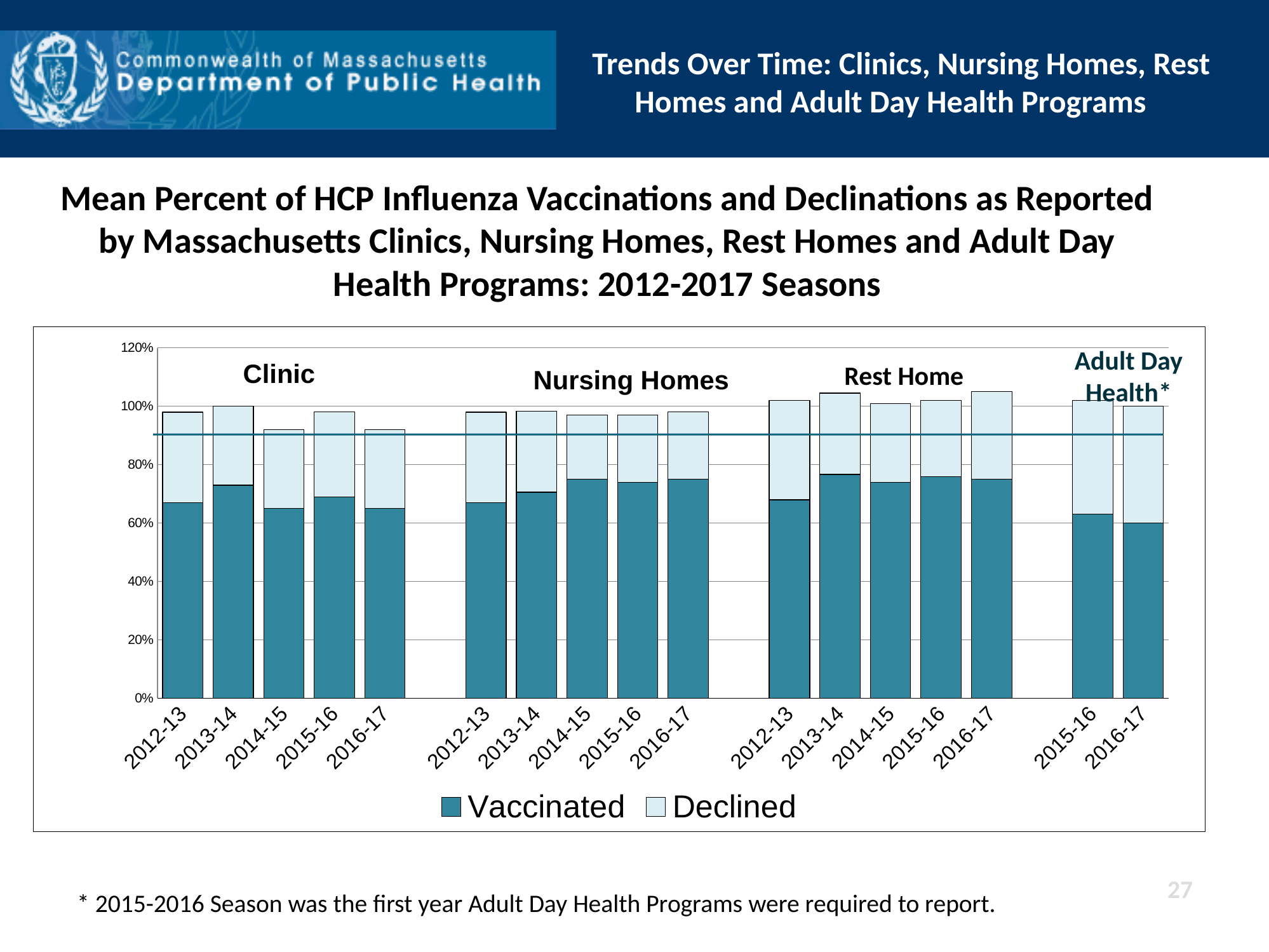
Within the Clinic group, which season has the highest Vaccinated value? 2013-14 Is the Vaccinated value for Clinic 2013-14 greater or less than 80%? less Which is larger, the Vaccinated value for Clinic 2013-14 or for Clinic 2014-15? Clinic 2013-14 Is the Vaccinated value for Adult Day Health 2015-16 greater or less than 60%? greater What kind of chart is shown on the slide? Stacked bar chart Is the Vaccinated value for Rest Home 2013-14 greater or less than 60%? greater How many facility-type groups are labelled on the chart? 4 How many seasons are plotted for the Adult Day Health group? 2 What are the two series named in the chart legend? Vaccinated and Declined How many bars are plotted in total on the chart? 17 How many series does the chart legend list? 2 Within the Nursing Homes group, which season has the lowest Vaccinated value? 2012-13